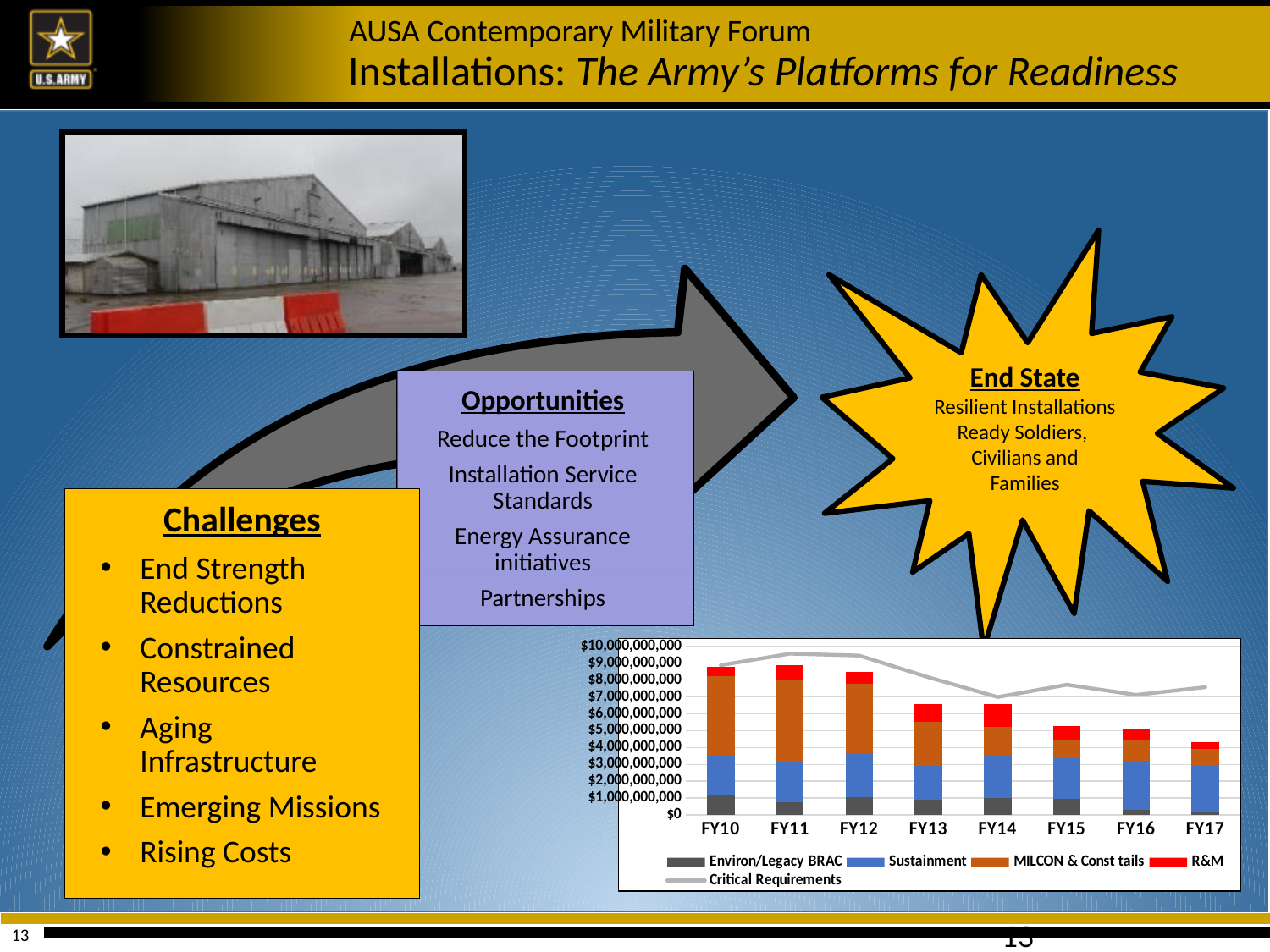
What kind of chart is shown at the bottom right of the slide? Bar chart (stacked bars with a line) Is the total stacked bar for FY13 greater or less than $6,000,000,000? greater Which has the larger total stacked bar, FY10 or FY17? FY10 Which series in the chart is drawn as a line rather than as bars? Critical Requirements Is the Critical Requirements line value for FY11 greater or less than $9,000,000,000? greater Do the total stacked bar values generally rise or fall from FY10 to FY17? fall How many series does the chart's legend list? 5 Which fiscal year has the lowest total stacked bar in the chart? FY17 Which has the larger total stacked bar, FY13 or FY15? FY13 Is the total stacked bar for FY17 greater or less than $5,000,000,000? less How many fiscal years are shown on the x axis of the chart? 8